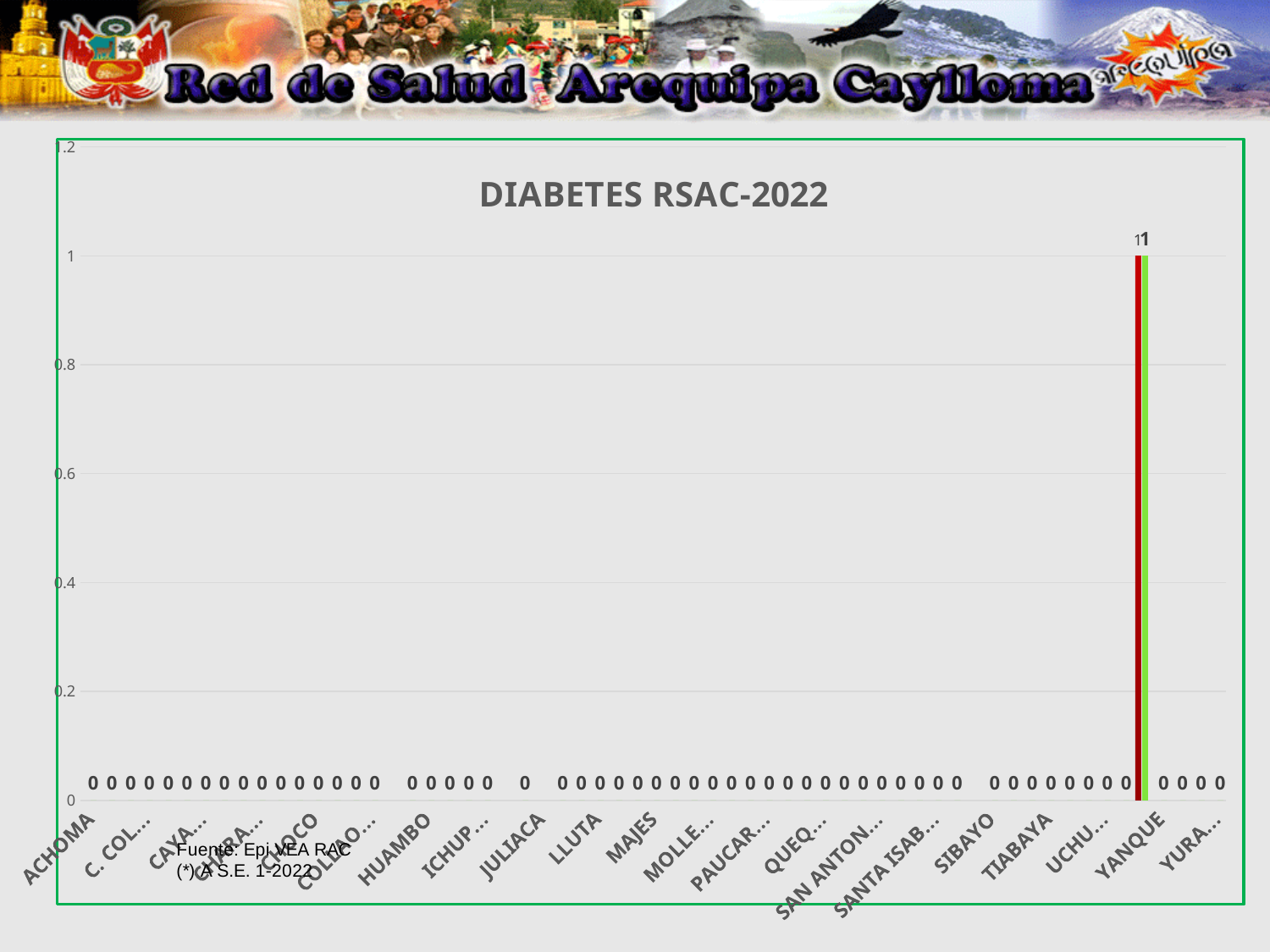
Which is larger, the value for YANQUE or the value for MAJES? Neither, both are 0 What is the difference between the value for YANQUE and the value for LLUTA? 0 What is the value shown for TIABAYA? 0 What is the value shown for SIBAYO? 0 What is the value shown for YANQUE? 0 Is the value for YANQUE greater or less than 0.8? less What is the value shown for HUAMBO? 0 What is the value shown for ACHOMA? 0 What is the highest tick value shown on the vertical axis? 1.2 What kind of chart is shown on the slide? bar chart What is the title of the chart? DIABETES RSAC-2022